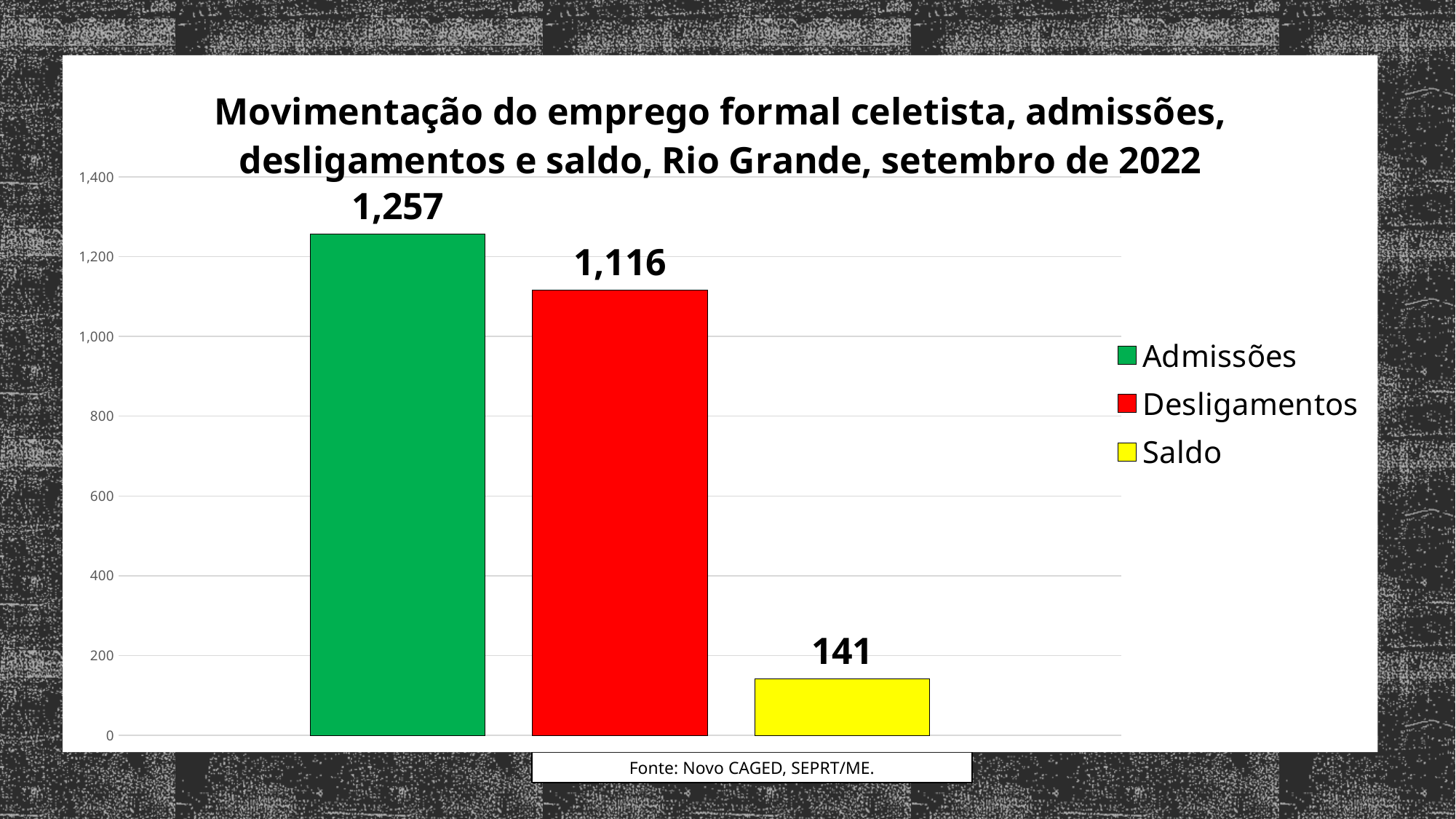
Which is larger, Admissões or Desligamentos? Admissões What is the value for Saldo? 141 Which series has the lowest value? Saldo What is the value for Admissões? 1,257 What is the difference between Admissões and Desligamentos? 141 Is the value for Desligamentos greater or less than 1,000? greater What kind of chart is shown on the slide? bar chart How many series does the legend list? 3 How many bars are plotted in the chart? 3 What is the value for Desligamentos? 1,116 Which series has the highest value? Admissões What colour is the bar for Saldo? yellow